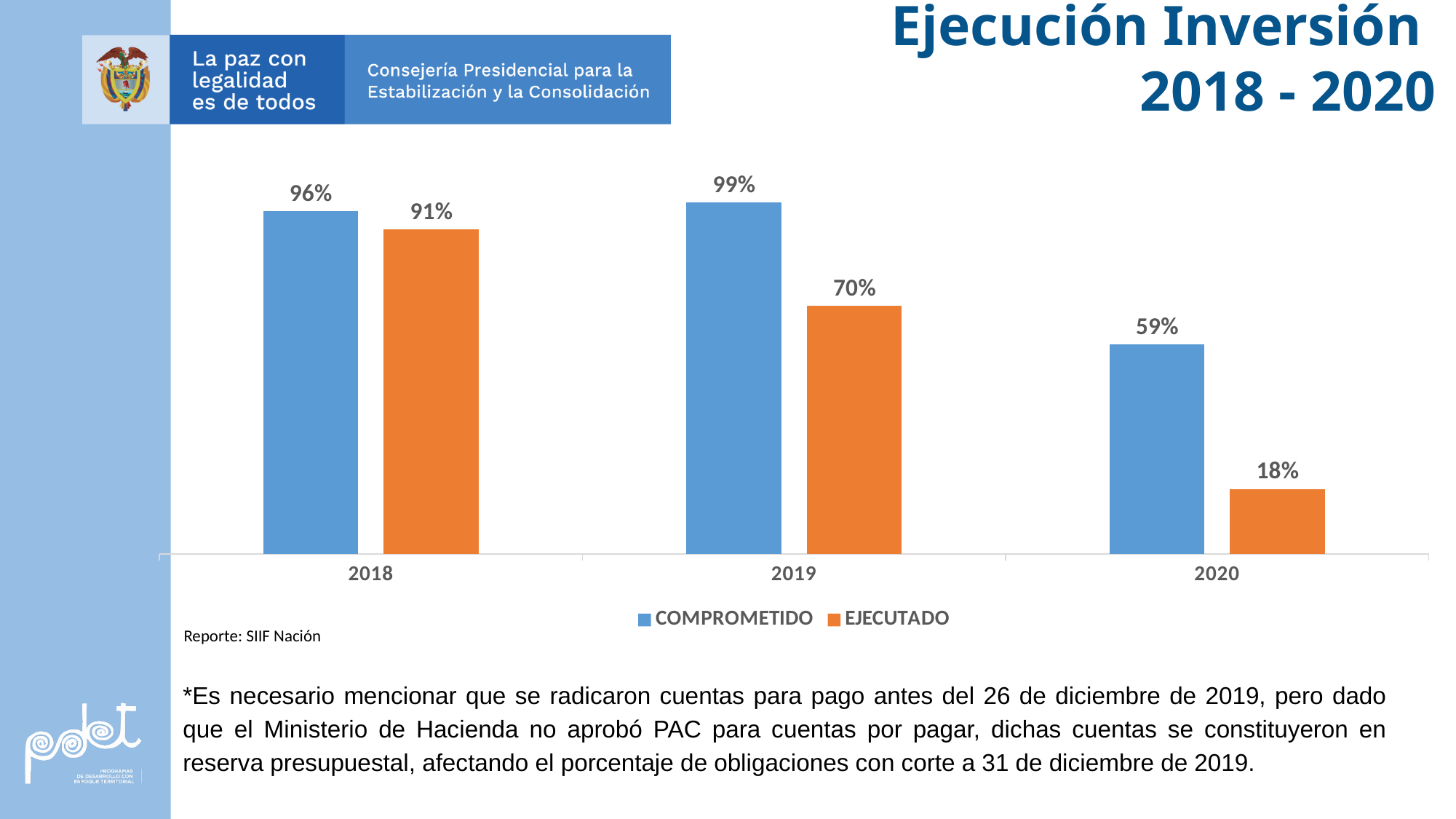
Which is larger, the COMPROMETIDO value for 2018 or the COMPROMETIDO value for 2020? 2018 How many years are shown on the x axis? 3 What is the difference between the EJECUTADO values for 2018 and 2019? 21% What is the difference between COMPROMETIDO and EJECUTADO in 2020? 41% What is the EJECUTADO value for 2020? 18% Do the EJECUTADO values rise or fall from 2018 to 2020? Fall What is the COMPROMETIDO value for 2018? 96% How many series does the legend list? 2 Which year has the highest COMPROMETIDO value? 2019 What is the EJECUTADO value for 2019? 70% What kind of chart is shown on the slide? Bar chart Which year has the lowest EJECUTADO value? 2020